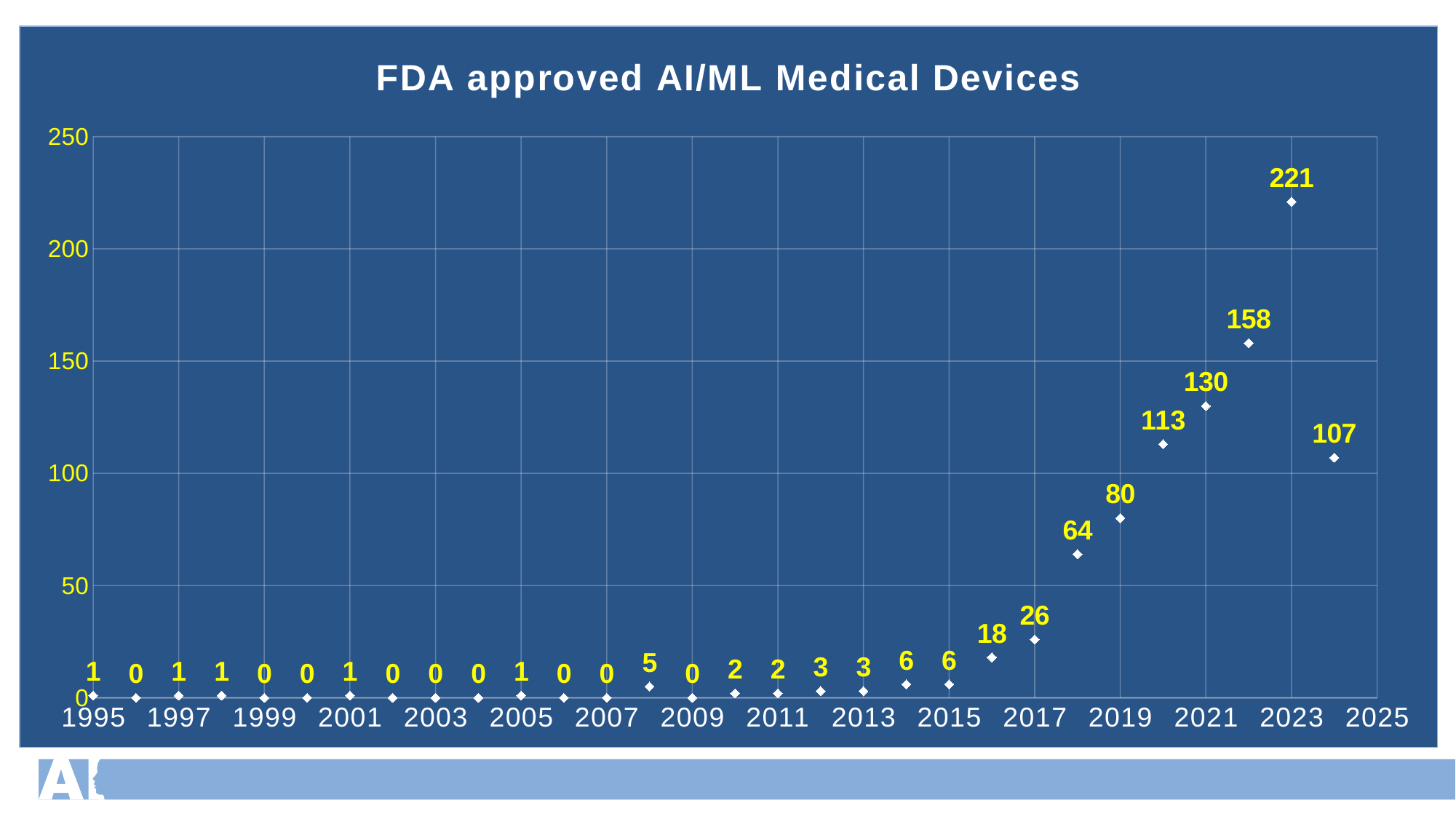
What is the value for 2024 in the chart? 107 What is the value for 2008 in the chart? 5 Is the value for 2022 greater or less than 150? greater Which year has the highest value in the chart? 2023 What is the difference between the values for 2023 and 2022? 63 How many data points are plotted in the chart? 30 What is the value for 2020 in the chart? 113 What is the difference between the values for 2023 and 2024? 114 What is the value for 2023 in the FDA approved AI/ML Medical Devices chart? 221 What kind of chart is shown on the slide? Scatter chart What is the title of the chart? FDA approved AI/ML Medical Devices Which year has the larger value, 2019 or 2021? 2021